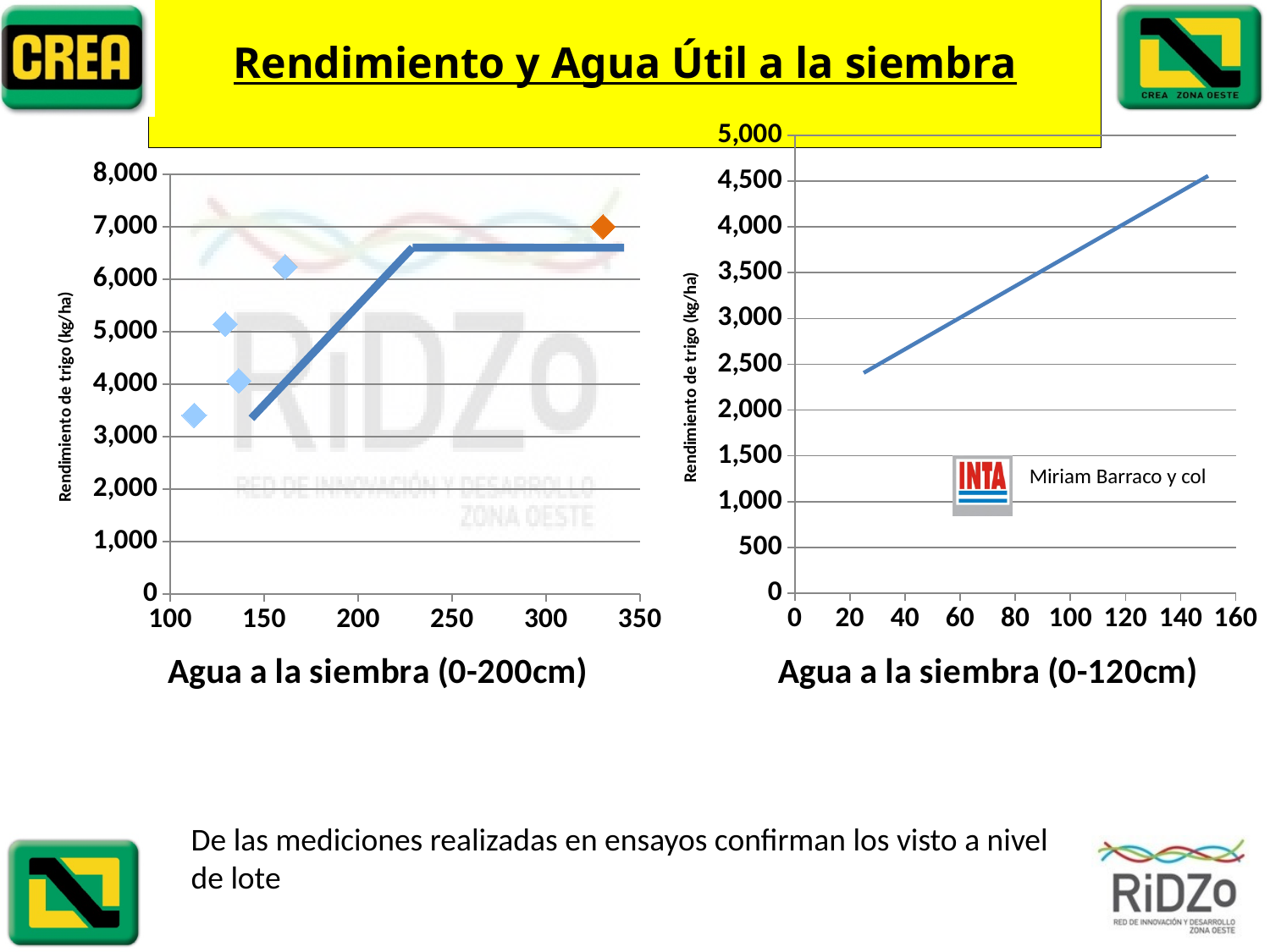
In the right-hand chart 'Agua a la siembra (0-120cm)', is the value at the left end of the line (around x = 25) greater or less than 3,000? less In the right-hand chart 'Agua a la siembra (0-120cm)', is the value of the line at x = 100 greater or less than 3,000? greater In the left-hand chart 'Agua a la siembra (0-200cm)', how many diamond data points are plotted? 5 What is the y-axis title of the left-hand chart 'Agua a la siembra (0-200cm)'? Rendimiento de trigo (kg/ha) In the left-hand chart 'Agua a la siembra (0-200cm)', is the leftmost blue diamond point (near x = 110) greater or less than 4,000 kg/ha? less In the left-hand chart 'Agua a la siembra (0-200cm)', which is higher: the orange diamond point or the leftmost blue diamond point? the orange diamond point What kind of chart is the right-hand chart titled 'Agua a la siembra (0-120cm)'? line chart In the right-hand chart 'Agua a la siembra (0-120cm)', do the values rise or fall as the x axis increases? rise What is the highest tick value shown on the y axis of the right-hand chart 'Agua a la siembra (0-120cm)'? 5,000